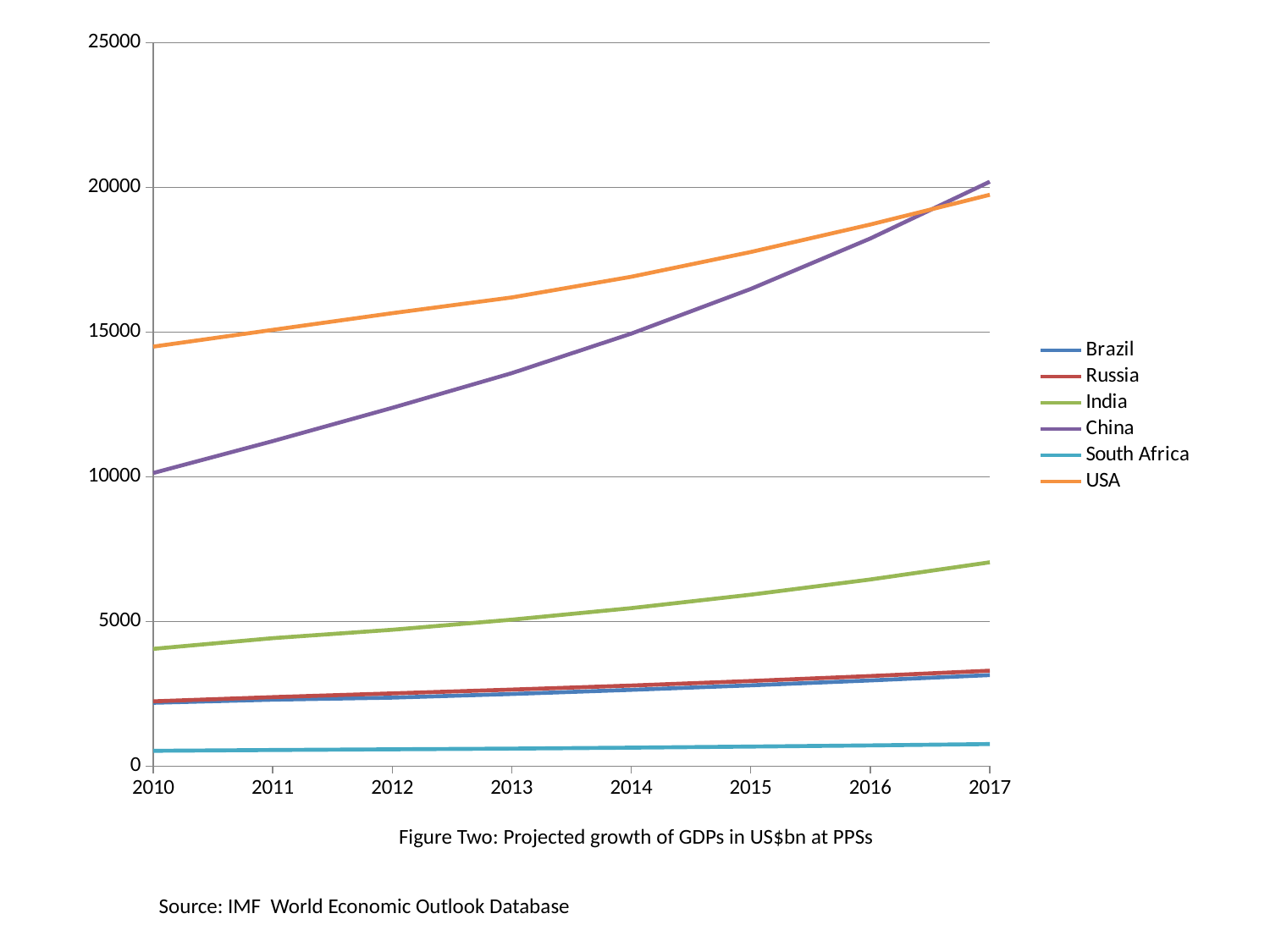
Which country has the highest value in 2010? USA Does the value for China rise or fall from 2010 to 2017? rise Is the value for USA in 2010 greater or less than 15000? less Which country has the highest value in 2017? China What is the caption shown below the chart? Figure Two: Projected growth of GDPs in US$bn at PPSs How many years are shown along the x axis? 8 What kind of chart is shown on the slide? line chart How many series does the legend list? 6 Which country has the lowest value across the chart? South Africa Is the value for India in 2017 greater or less than 5000? greater Is the value for USA in 2017 greater or less than 20000? less In 2017, which is larger, the value for China or the value for USA? China